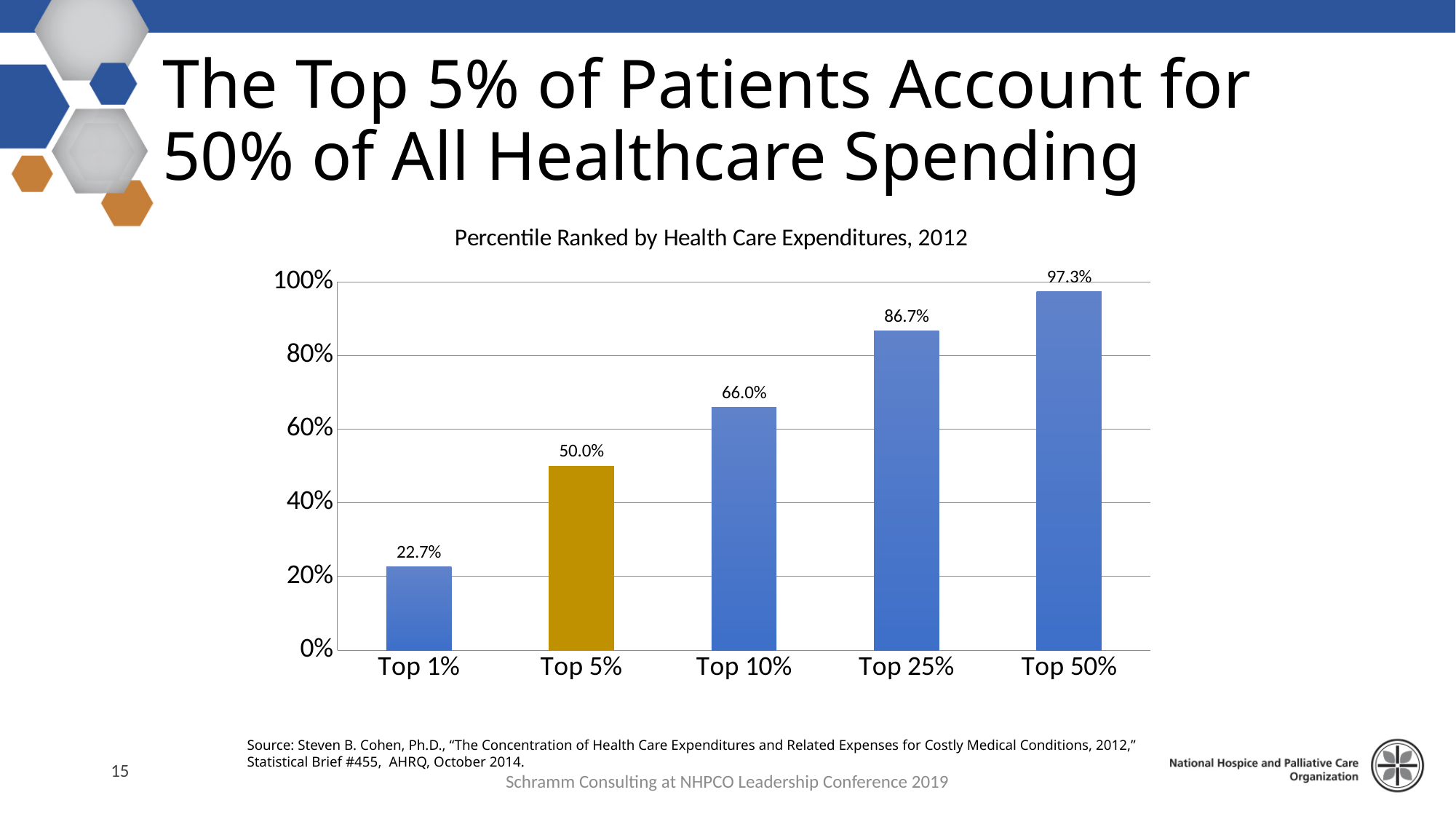
What is the difference between the values for Top 10% and Top 5%? 16.0% Which category has the lowest value? Top 1% What is the value for Top 5%? 50.0% Which category has the highest value? Top 50% What is the difference between the values for Top 50% and Top 25%? 10.6% What is the value for Top 25%? 86.7% What kind of chart is shown on the slide? bar chart Do the values rise or fall from Top 1% to Top 50%? rise What is the value for Top 1%? 22.7% Which is larger, the value for Top 10% or the value for Top 25%? Top 25% Which bar is coloured differently (gold) from the others? Top 5% How many categories are shown on the x axis? 5